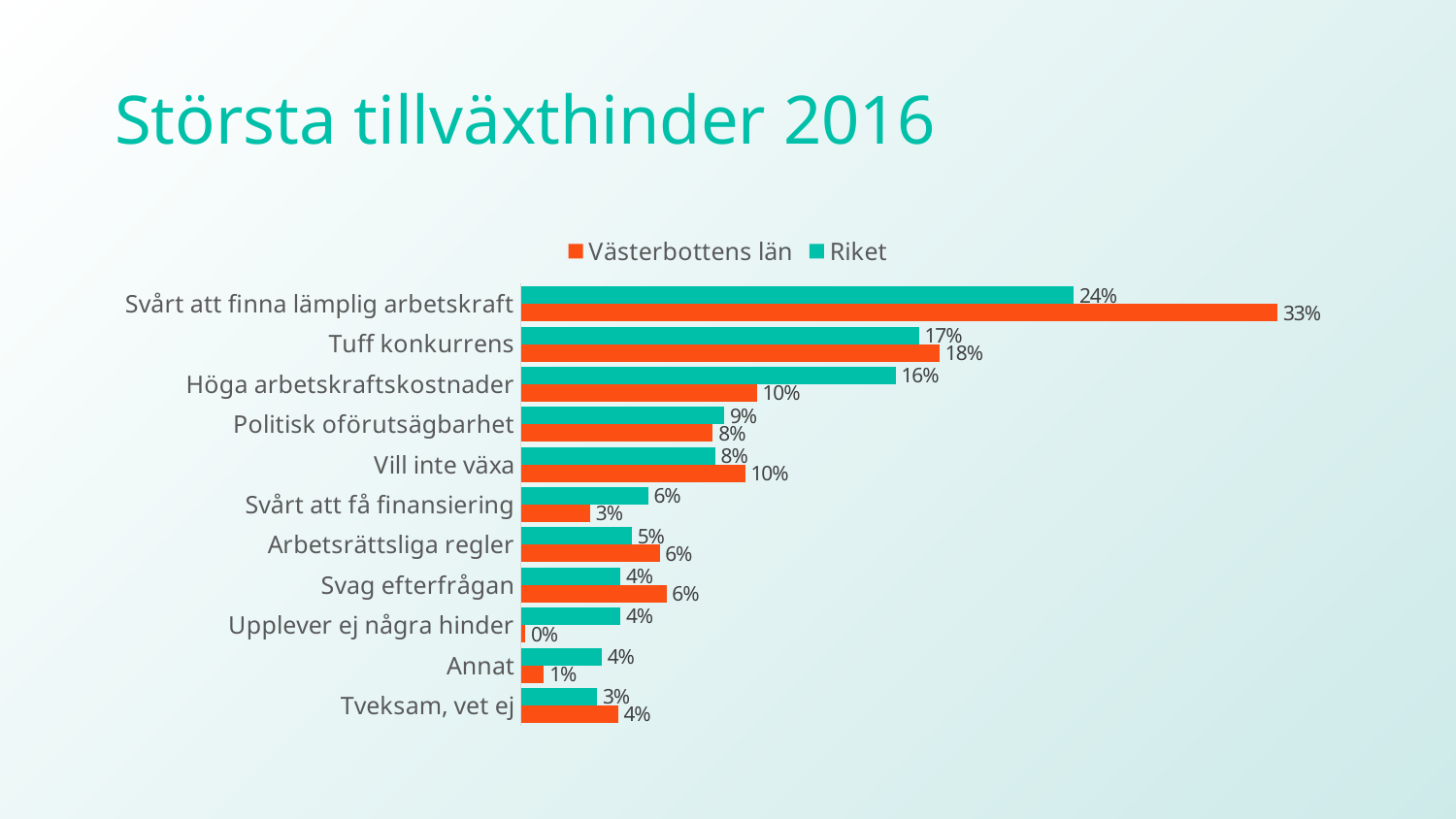
How many series does the legend list? 2 For 'Höga arbetskraftskostnader', which is larger: Västerbottens län or Riket? Riket What is the value for Västerbottens län for 'Svårt att finna lämplig arbetskraft'? 33% What kind of chart is shown on the slide? Bar chart Which category has the highest value for Riket? Svårt att finna lämplig arbetskraft Which category has the lowest value for Västerbottens län? Upplever ej några hinder How many categories are shown in the chart? 11 What is the value for Västerbottens län for 'Upplever ej några hinder'? 0% What is the title of the slide? Största tillväxthinder 2016 What is the value for Riket for 'Höga arbetskraftskostnader'? 16% What is the difference between Riket and Västerbottens län for 'Svårt att få finansiering'? 3% What is the difference between Västerbottens län and Riket for 'Svårt att finna lämplig arbetskraft'? 9%